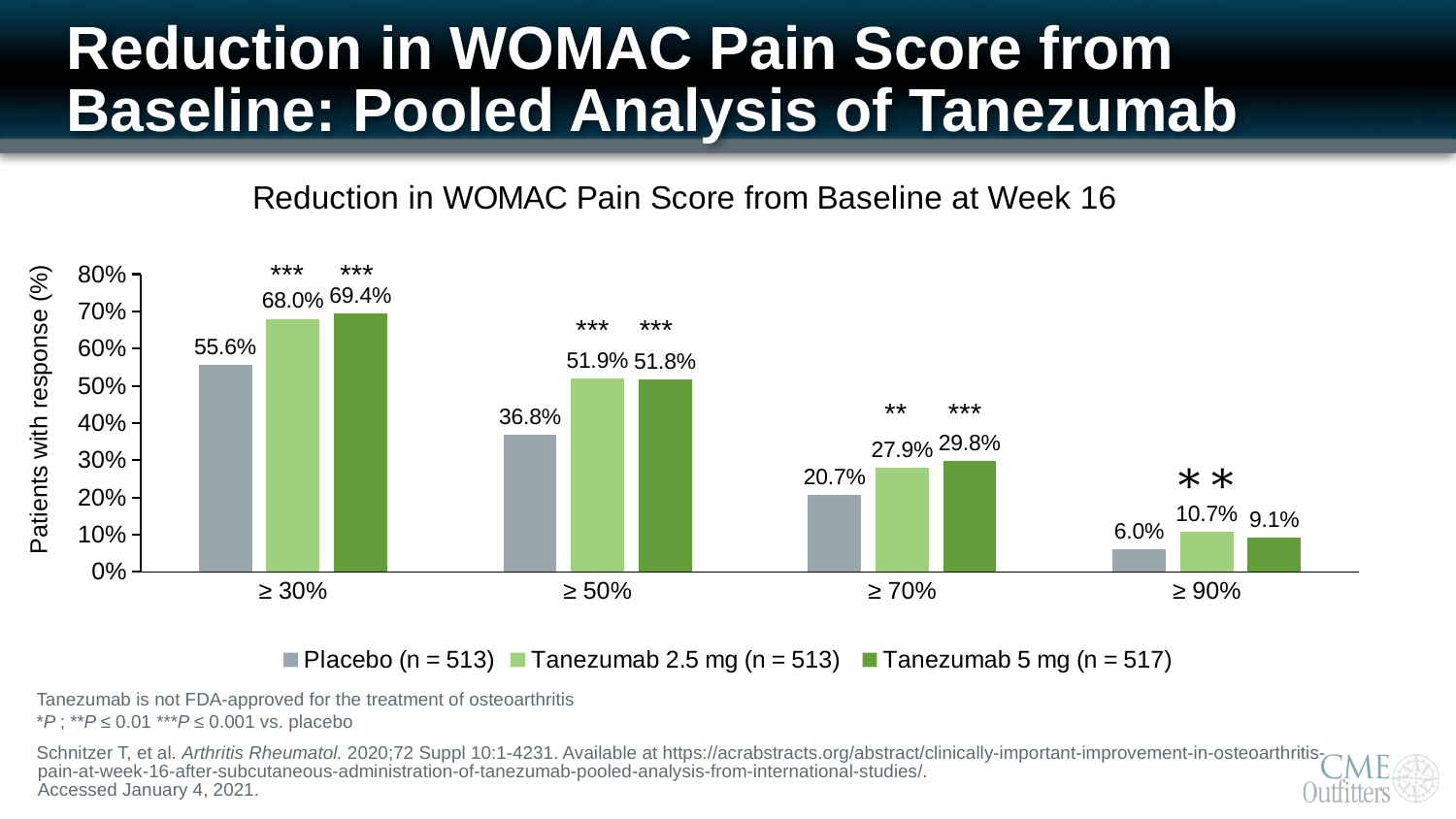
In the ≥ 70% category, which is larger: Placebo or Tanezumab 2.5 mg? Tanezumab 2.5 mg What is the value for Tanezumab 2.5 mg in the ≥ 90% category? 10.7% What is the value for Tanezumab 5 mg in the ≥ 70% category? 29.8% How many response categories are shown on the x axis? 4 How many series does the legend list? 3 Which category has the lowest Tanezumab 5 mg value? ≥ 90% Which category has the highest Placebo value? ≥ 30% What kind of chart is shown? Bar chart What is the difference between Tanezumab 2.5 mg and Placebo in the ≥ 50% category? 15.1% What is the title of the chart? Reduction in WOMAC Pain Score from Baseline at Week 16 Do the Placebo values rise or fall from ≥ 30% to ≥ 90%? Fall What is the value for Placebo in the ≥ 30% category? 55.6%